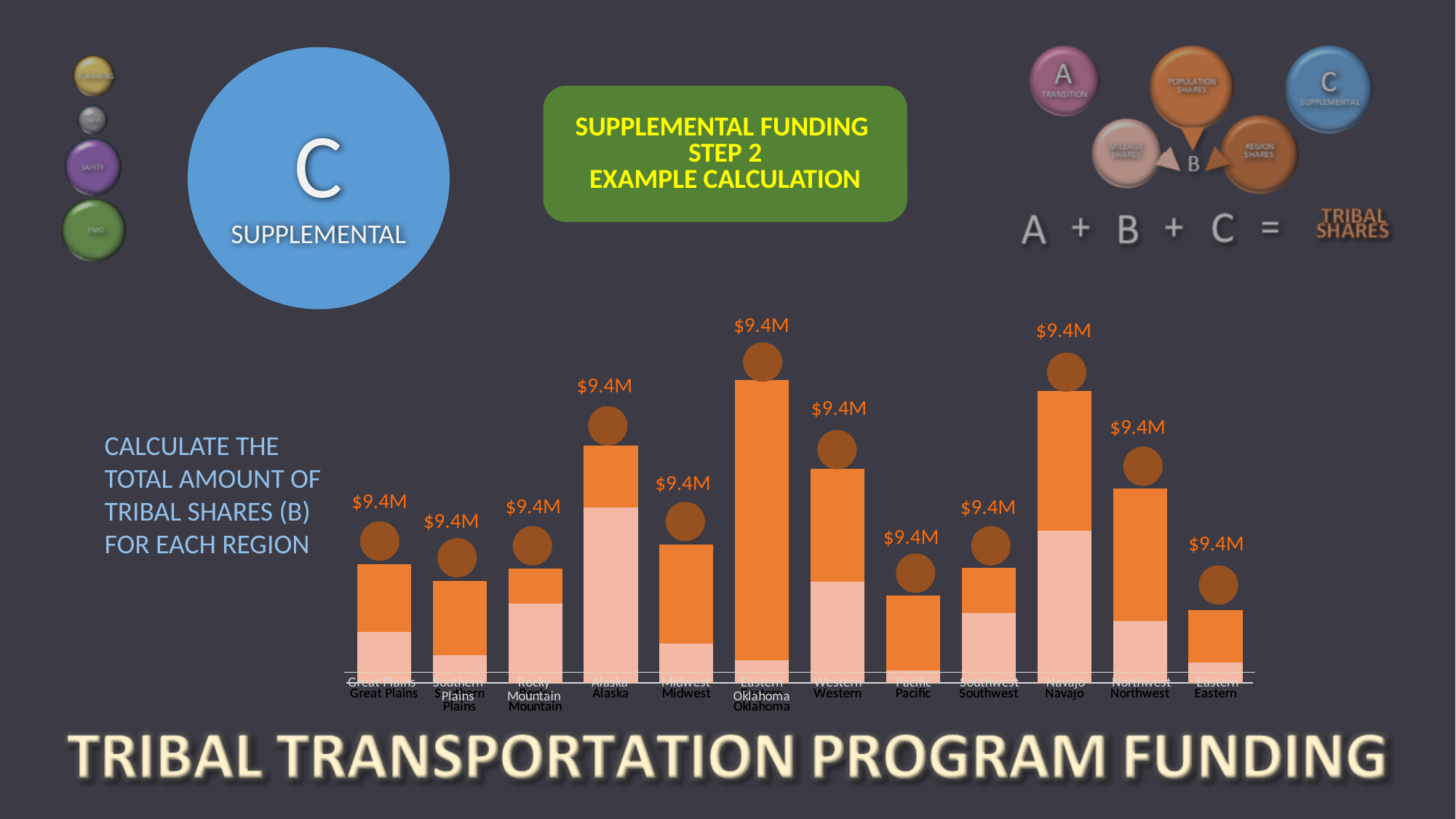
What value is labelled above the bar for Navajo? $9.4M What value is labelled above the bar for Pacific? $9.4M What value is labelled above the bar for Alaska? $9.4M Which bar is taller, Navajo or Alaska? Navajo Which bar is taller, Western or Midwest? Western What is the first region listed on the x axis of the chart? Great Plains Which region has the shortest bar in the chart? Eastern How many regions are shown on the x axis of the chart? 12 Which bar is taller, Great Plains or Pacific? Great Plains Which region has the tallest bar in the chart? Eastern Oklahoma How many stacked segments does each bar in the chart have? 2 What kind of chart is shown on the slide? bar chart